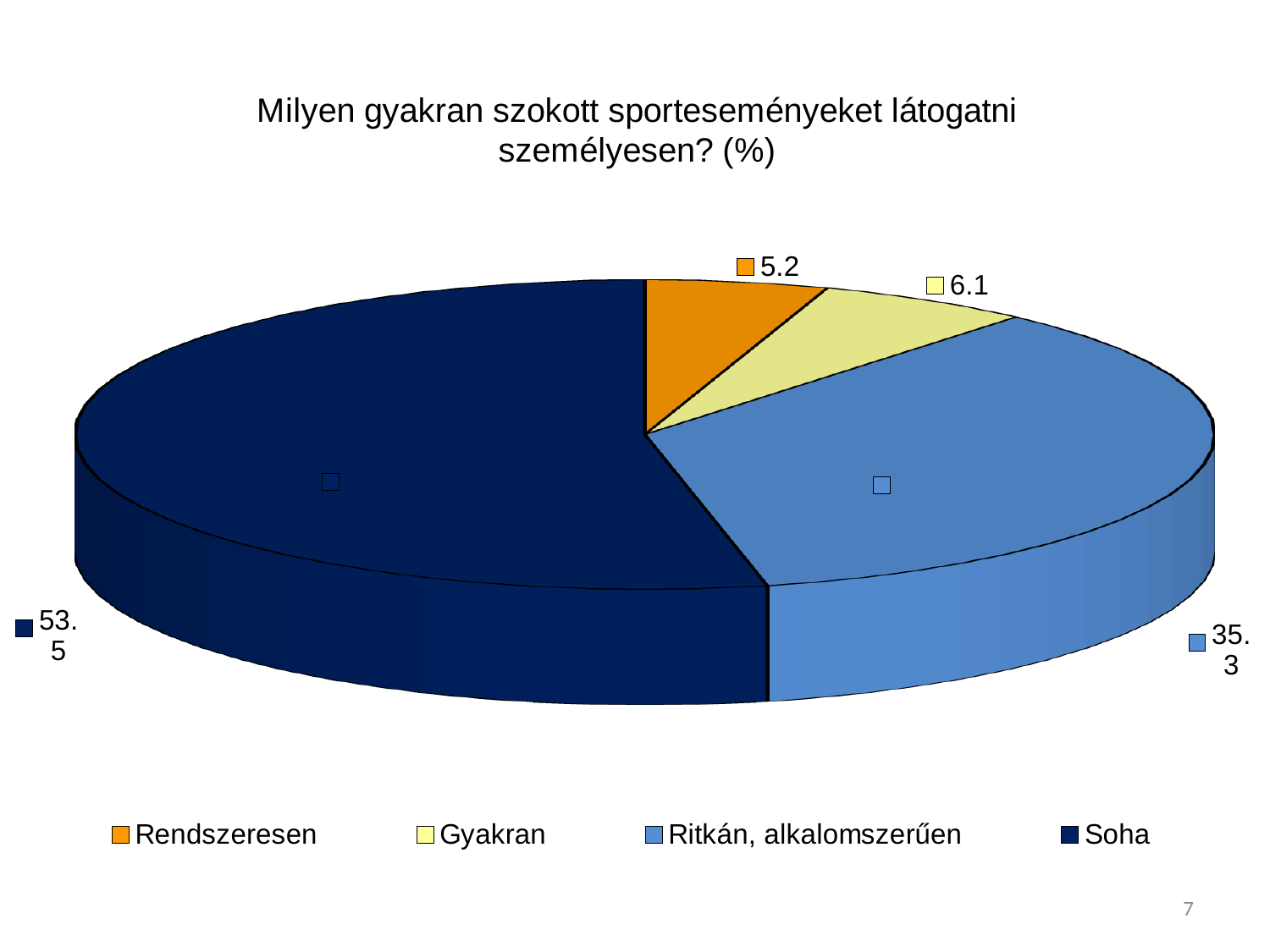
What is the value for "Soha"? 53.5 What is the value for "Rendszeresen"? 5.2 Which category has the smallest slice of the pie? Rendszeresen Which category has the largest slice of the pie? Soha What is the title of the chart? Milyen gyakran szokott sporteseményeket látogatni személyesen? (%) What is the difference between the values for "Soha" and "Ritkán, alkalomszerűen"? 18.2 What type of chart is shown on the slide? pie chart How many slices does the pie chart have? 4 Which is larger, the value for "Gyakran" or the value for "Rendszeresen"? Gyakran What is the difference between the values for "Gyakran" and "Rendszeresen"? 0.9 What is the value for "Gyakran"? 6.1 What is the value for "Ritkán, alkalomszerűen"? 35.3